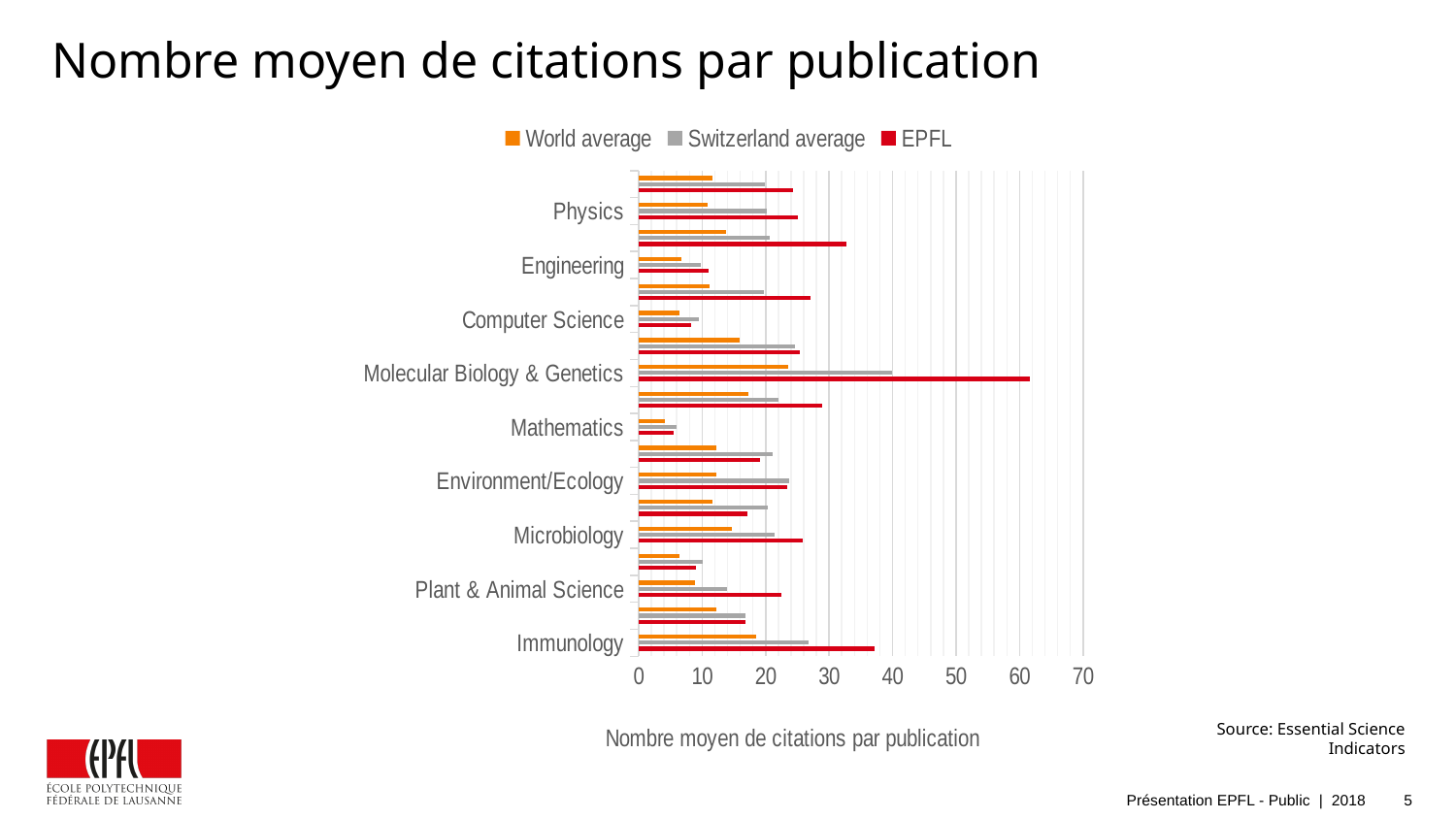
For Immunology, which is larger: the EPFL value or the Switzerland average? EPFL Is the EPFL value for Immunology greater or less than 30? greater Is the World average value for Computer Science greater or less than 10? less How many series does the legend list? 3 Is the EPFL value for Mathematics greater or less than 10? less What is the title of the chart? Nombre moyen de citations par publication Which labeled field has the lowest EPFL value? Mathematics Which labeled field has the highest EPFL value? Molecular Biology & Genetics Which series are listed in the legend? World average, Switzerland average, EPFL For Molecular Biology & Genetics, which is larger: the World average or the Switzerland average? Switzerland average What kind of chart is shown on the slide? bar chart